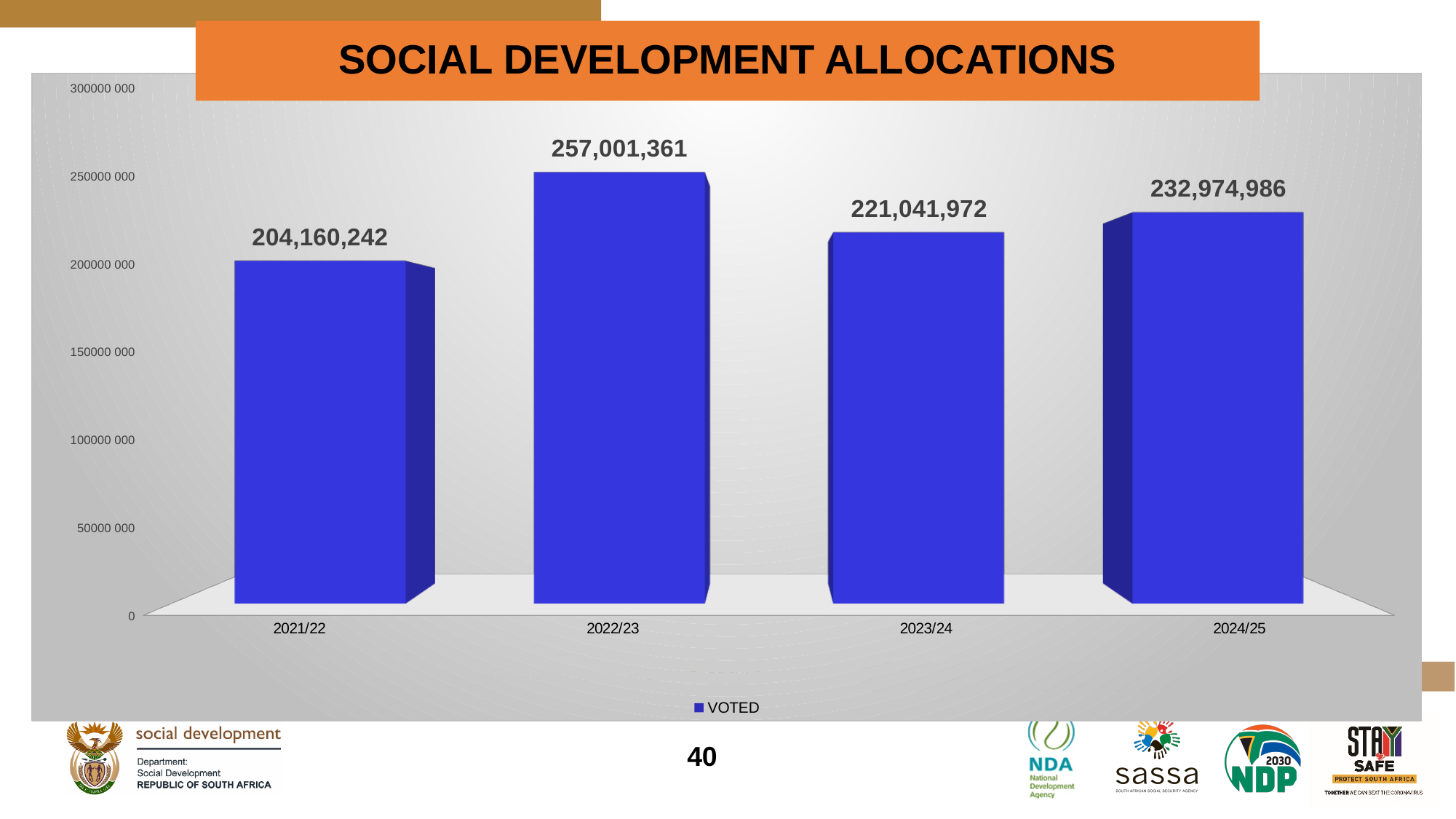
What is the title of the chart? SOCIAL DEVELOPMENT ALLOCATIONS What kind of chart is shown on the slide? Bar chart Which year has the lowest allocation? 2021/22 Which year has the highest allocation? 2022/23 What is the value for 2024/25? 232,974,986 What is the value for 2022/23? 257,001,361 What is the value for 2023/24? 221,041,972 What is the difference between the values for 2024/25 and 2023/24? 11,933,014 What is the difference between the values for 2022/23 and 2021/22? 52,841,119 How many years are shown on the chart? 4 What is the value for 2021/22? 204,160,242 Which is larger, the value for 2023/24 or the value for 2024/25? 2024/25